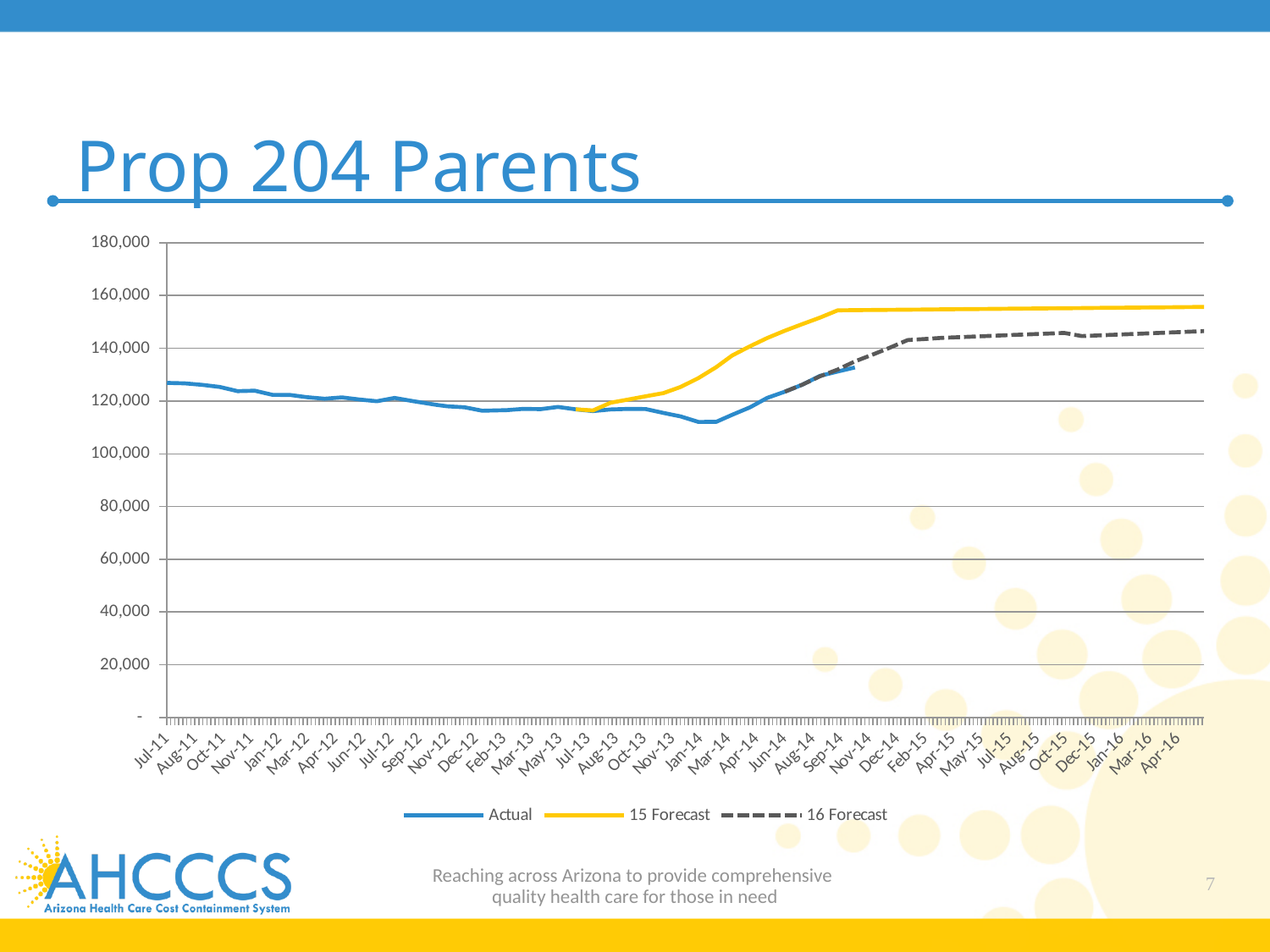
How many series does the legend list? 3 Is the Actual value for Jul-11 greater or less than 120,000? greater Is the 15 Forecast value for Apr-16 greater or less than 160,000? less Does the Actual series rise or fall from Jul-11 to Jan-14? fall Is the 15 Forecast value for Sep-14 greater or less than 140,000? greater Does the 15 Forecast series rise or fall from Jul-13 to Sep-14? rise Which series is drawn with a dashed line? 16 Forecast What kind of chart is shown on the slide? line chart At Apr-16, which series is higher: 15 Forecast or 16 Forecast? 15 Forecast What is the title of the chart? Prop 204 Parents